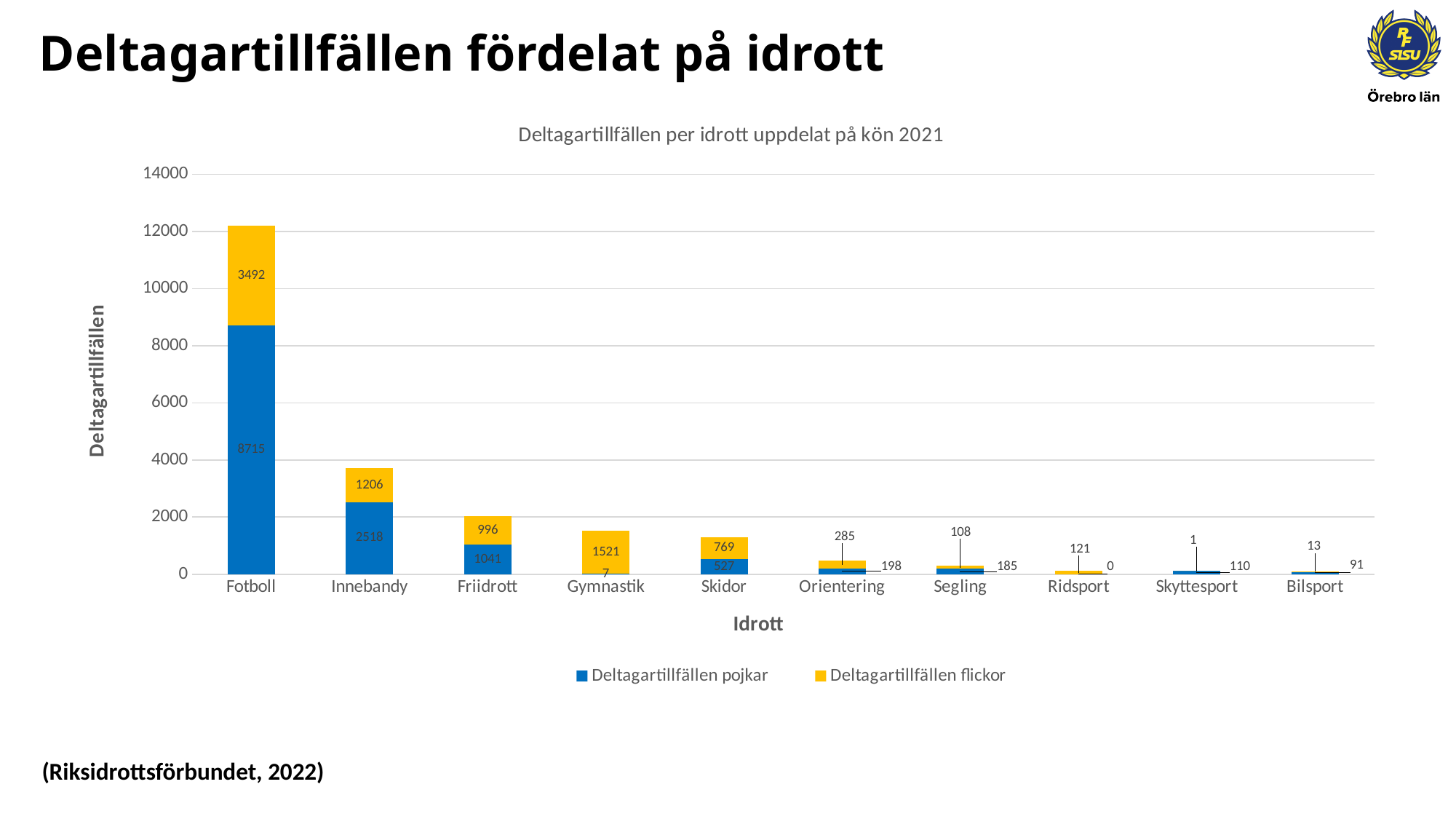
What is the difference between Deltagartillfällen pojkar and Deltagartillfällen flickor for Fotboll? 5223 Is the total value for Friidrott greater or less than 1000? greater What is the value of Deltagartillfällen flickor for Ridsport? 121 What is the value of Deltagartillfällen pojkar for Fotboll? 8715 How many sports (categories) are shown on the x axis? 10 What is the value of Deltagartillfällen flickor for Gymnastik? 1521 What is the total of the stacked bar for Innebandy? 3724 For Skidor, which is larger: Deltagartillfällen pojkar or Deltagartillfällen flickor? Deltagartillfällen flickor How many series does the legend list? 2 Which sport has the highest total number of Deltagartillfällen? Fotboll What type of chart is shown on the slide? Stacked bar chart What is the title of the chart? Deltagartillfällen per idrott uppdelat på kön 2021